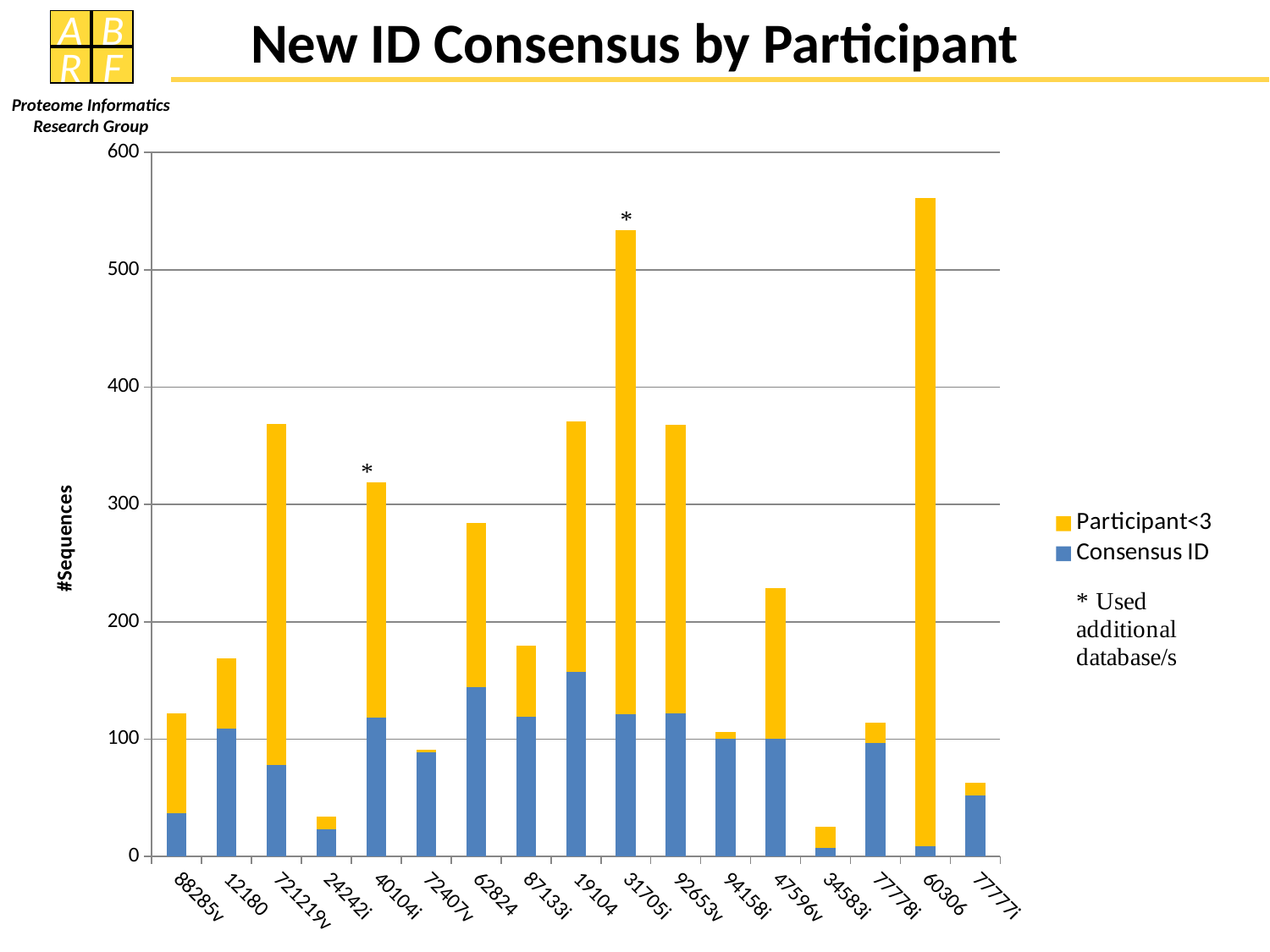
Is the Consensus ID value for 19104 greater or less than 100? greater What kind of chart is shown on the slide? stacked bar chart How many series does the legend list? 2 Which participant has the largest Consensus ID value? 19104 Which participant has the tallest total bar? 60306 How many participants (categories) are shown on the x axis? 17 Which has a taller total bar, 721219v or 62824? 721219v Which participant has the shortest total bar? 34583i Is the total bar for 24242i greater or less than 100? less Which series is shown in blue? Consensus ID Is the total bar for 60306 greater or less than 500? greater What is the title of the chart? New ID Consensus by Participant